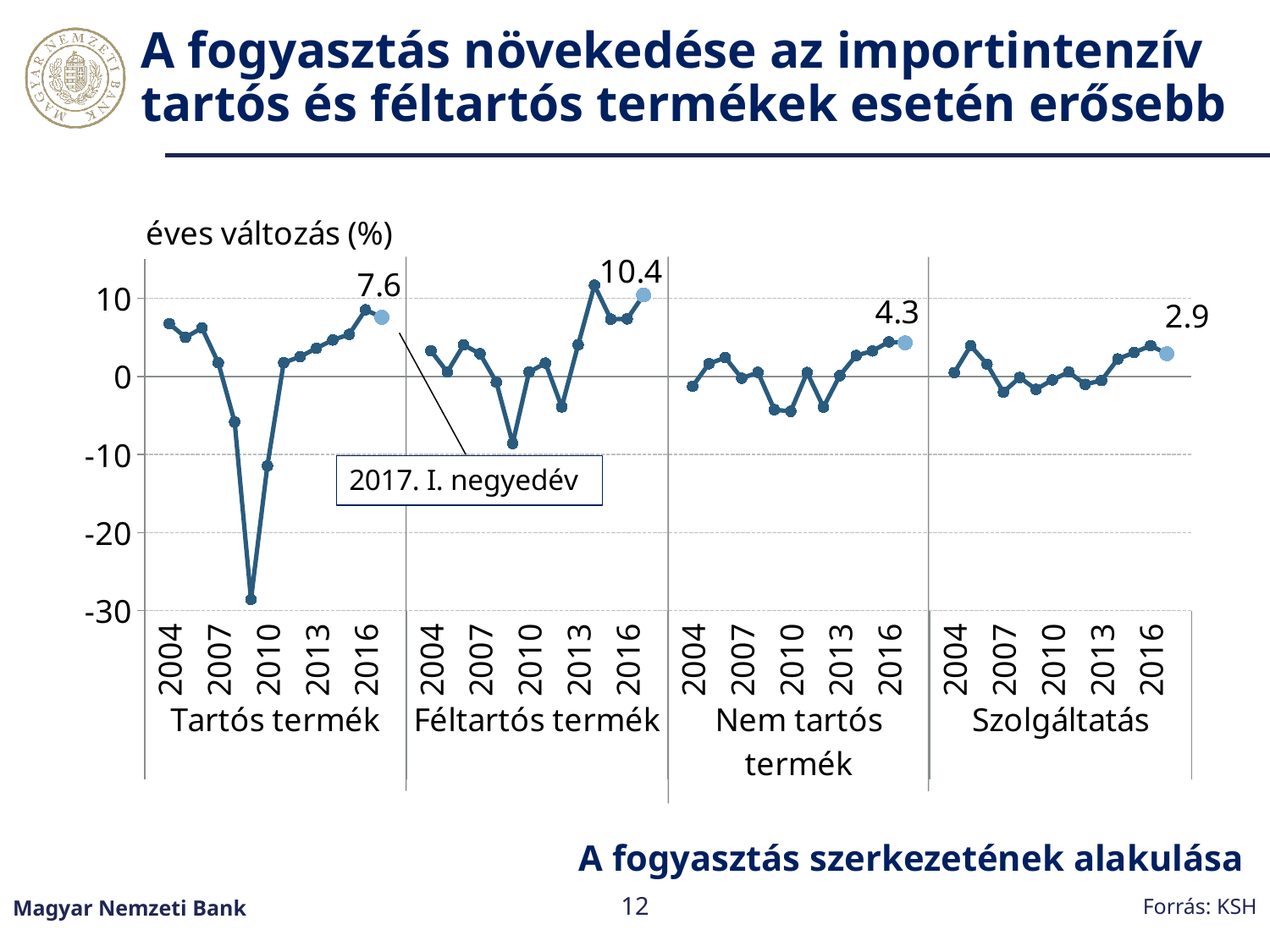
Is the lowest point of the Tartós termék line (around 2009) greater or less than -20? less What is the labelled value for Tartós termék at 2017. I. negyedév? 7.6 Which is larger at 2017. I. negyedév: the value for Tartós termék or for Nem tartós termék? Tartós termék How many product categories (panels) does the chart show? 4 What kind of chart is shown on the slide? line chart What is the labelled value for Nem tartós termék at 2017. I. negyedév? 4.3 What is the difference between the 2017. I. negyedév values of Féltartós termék and Tartós termék? 2.8 What is the labelled value for Féltartós termék at 2017. I. negyedév? 10.4 What is the labelled value for Szolgáltatás at 2017. I. negyedév? 2.9 Which category has the lowest labelled value for 2017. I. negyedév? Szolgáltatás Which category has the highest labelled value for 2017. I. negyedév? Féltartós termék What is the title of the chart shown below the plot? A fogyasztás szerkezetének alakulása